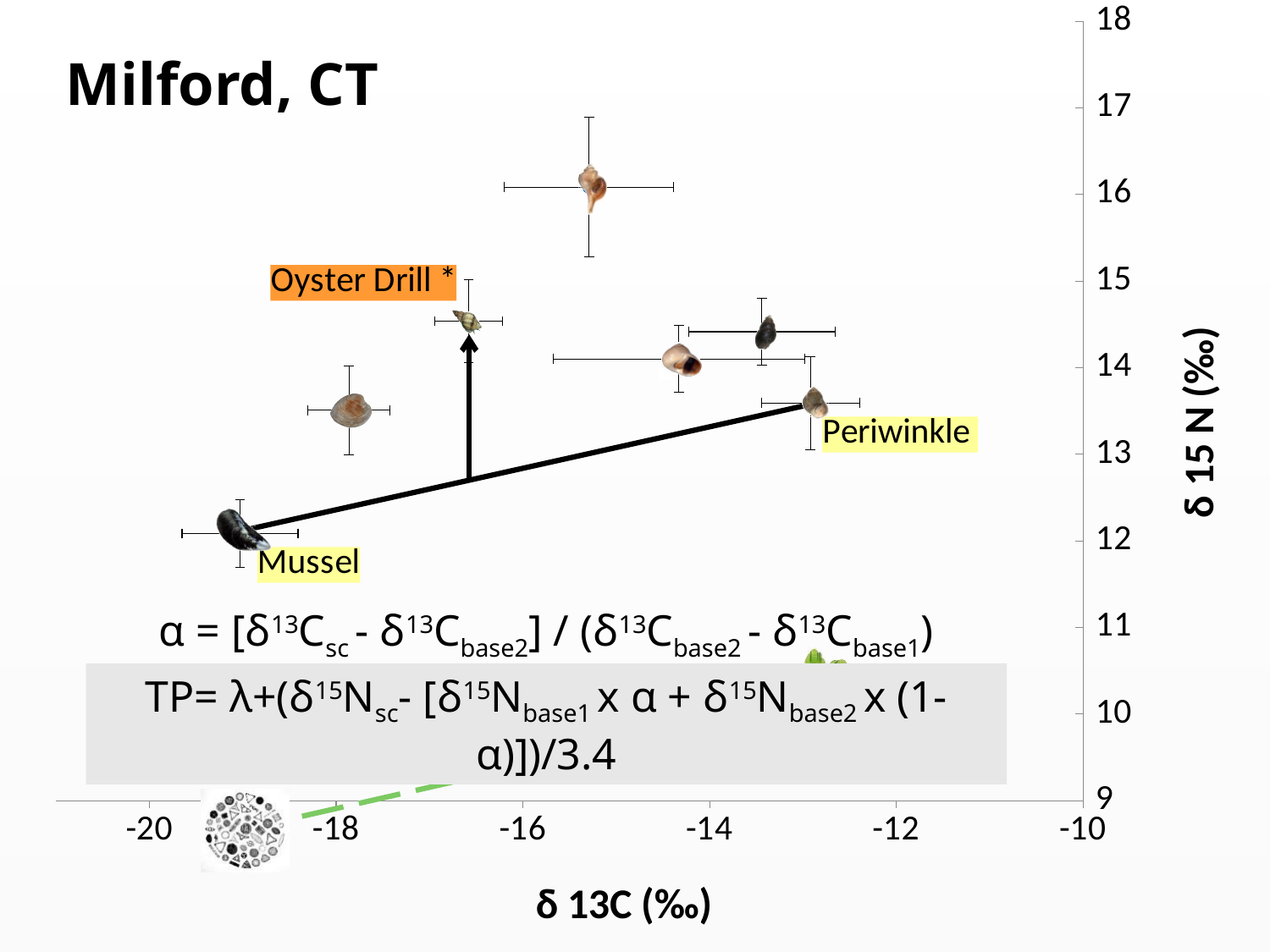
Is the δ 15 N value for Periwinkle greater or less than 13? greater How many species are labeled by name on the chart? 3 Which has the higher δ 13C value, Mussel or Periwinkle? Periwinkle Is the δ 15 N value for Oyster Drill greater or less than 14? greater Is the δ 15 N value for Mussel greater or less than 13? less What is the title of the chart? Milford, CT What is the label on the vertical axis of the chart? δ 15 N (‰) Of the three labeled species, which has the lowest δ 15 N value? Mussel Which has the higher δ 15 N value, Mussel or Periwinkle? Periwinkle What kind of chart is shown on the slide? Scatter chart